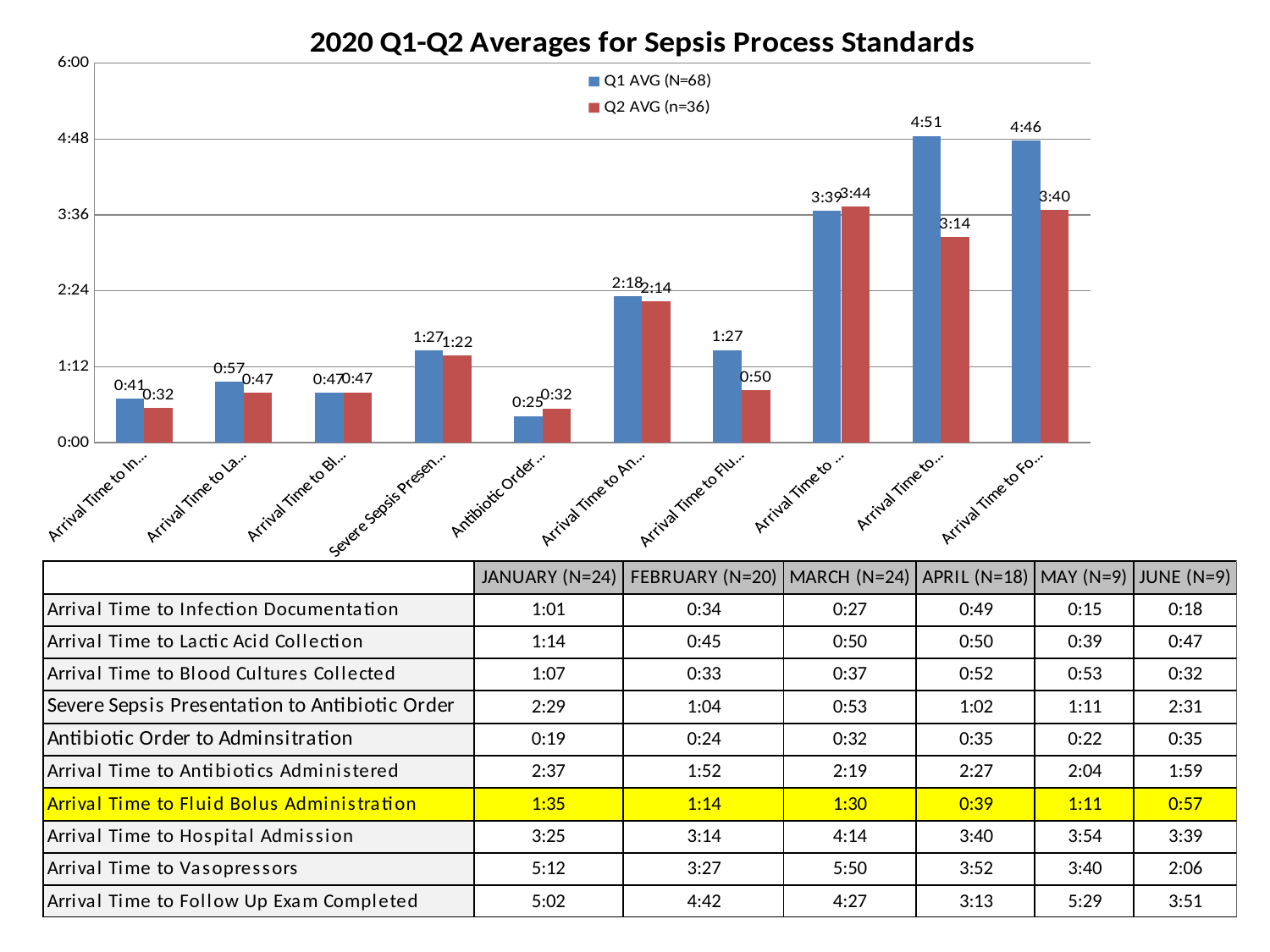
What is the title of the chart? 2020 Q1-Q2 Averages for Sepsis Process Standards For the category labelled "Arrival Time to Flu...", which is larger, the Q1 AVG or the Q2 AVG? Q1 AVG What is the Q2 AVG (n=36) value for the last category on the right, labelled "Arrival Time to Fo..."? 3:40 How many categories are plotted along the x axis of the chart? 10 For the category labelled "Arrival Time to Flu...", what is the difference between the Q1 AVG (1:27) and the Q2 AVG (0:50)? 0:37 Which category has the lowest Q1 AVG (N=68) value in the chart? Antibiotic Order ... What type of chart is shown on the slide? bar chart Is the Q2 AVG value for the last category on the right greater or less than 2:24? greater How many series does the chart legend list? 2 What is the Q2 AVG (n=36) value for the category labelled "Antibiotic Order ..."? 0:32 What is the Q1 AVG (N=68) value for the category labelled "Severe Sepsis Presen..."? 1:27 What is the highest Q1 AVG (N=68) value shown in the chart? 4:51